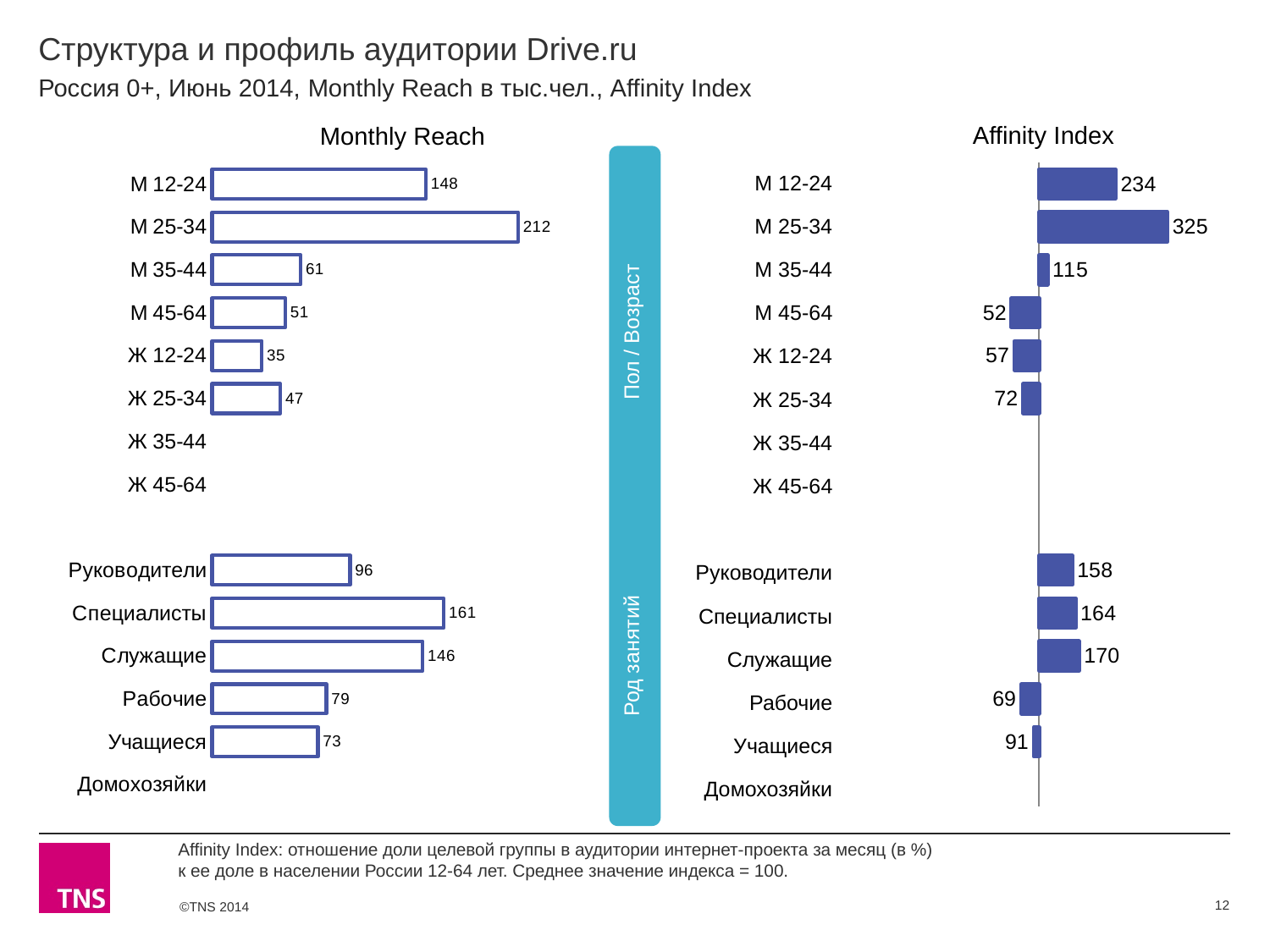
In the Affinity Index chart, what is the value for Служащие? 170 What kind of chart is the Monthly Reach chart? Bar chart In the Affinity Index chart, what is the difference between М 25-34 and М 12-24? 91 In the Monthly Reach chart, what is the value for М 25-34? 212 In the Affinity Index chart, which is larger: Ж 12-24 or Ж 25-34? Ж 25-34 In the Affinity Index chart, which category has the highest value? М 25-34 In the Affinity Index chart, what is the value for Учащиеся? 91 In the Monthly Reach chart, which is larger: Рабочие or Учащиеся? Рабочие In the Affinity Index chart, which category has the lowest value? М 45-64 In the Monthly Reach chart, what is the value for Ж 12-24? 35 In the Monthly Reach chart, which category has the highest value? М 25-34 In the Monthly Reach chart, what is the difference between Специалисты and Служащие? 15